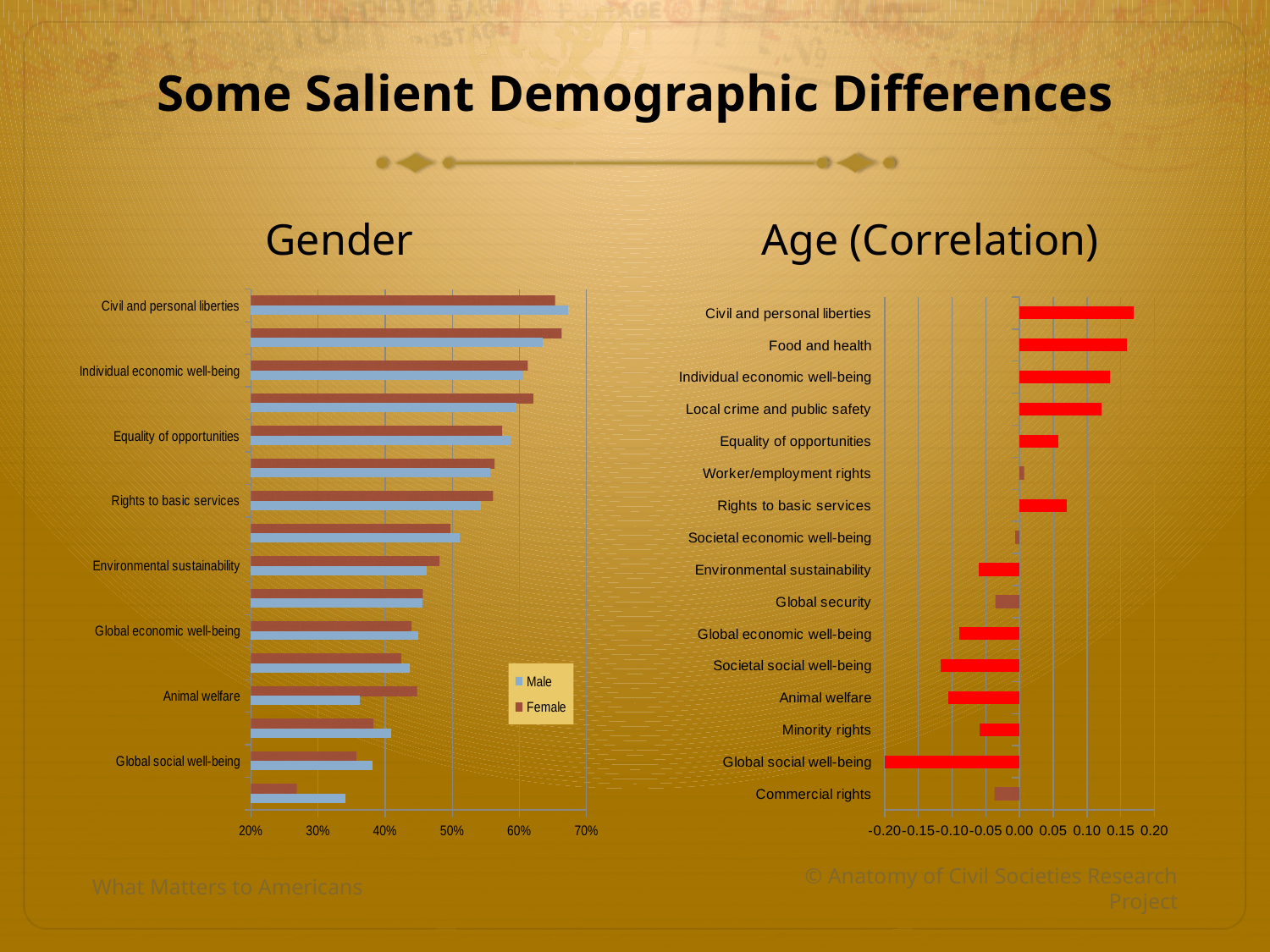
In the Age (Correlation) chart, is the value for Equality of opportunities greater or less than 0.10? less How many categories are plotted in the Age (Correlation) chart? 16 In the Age (Correlation) chart, is the value for Civil and personal liberties greater or less than 0.15? greater In the Gender chart, for Animal welfare, which is larger, the Male value or the Female value? Female What are the two legend entries in the Gender chart? Male and Female In the Gender chart, is the Male value for Global social well-being greater or less than 40%? less How many series does the legend of the Gender chart list? 2 What kind of chart is the Gender chart? bar chart In the Age (Correlation) chart, which category has the lowest (most negative) value? Global social well-being